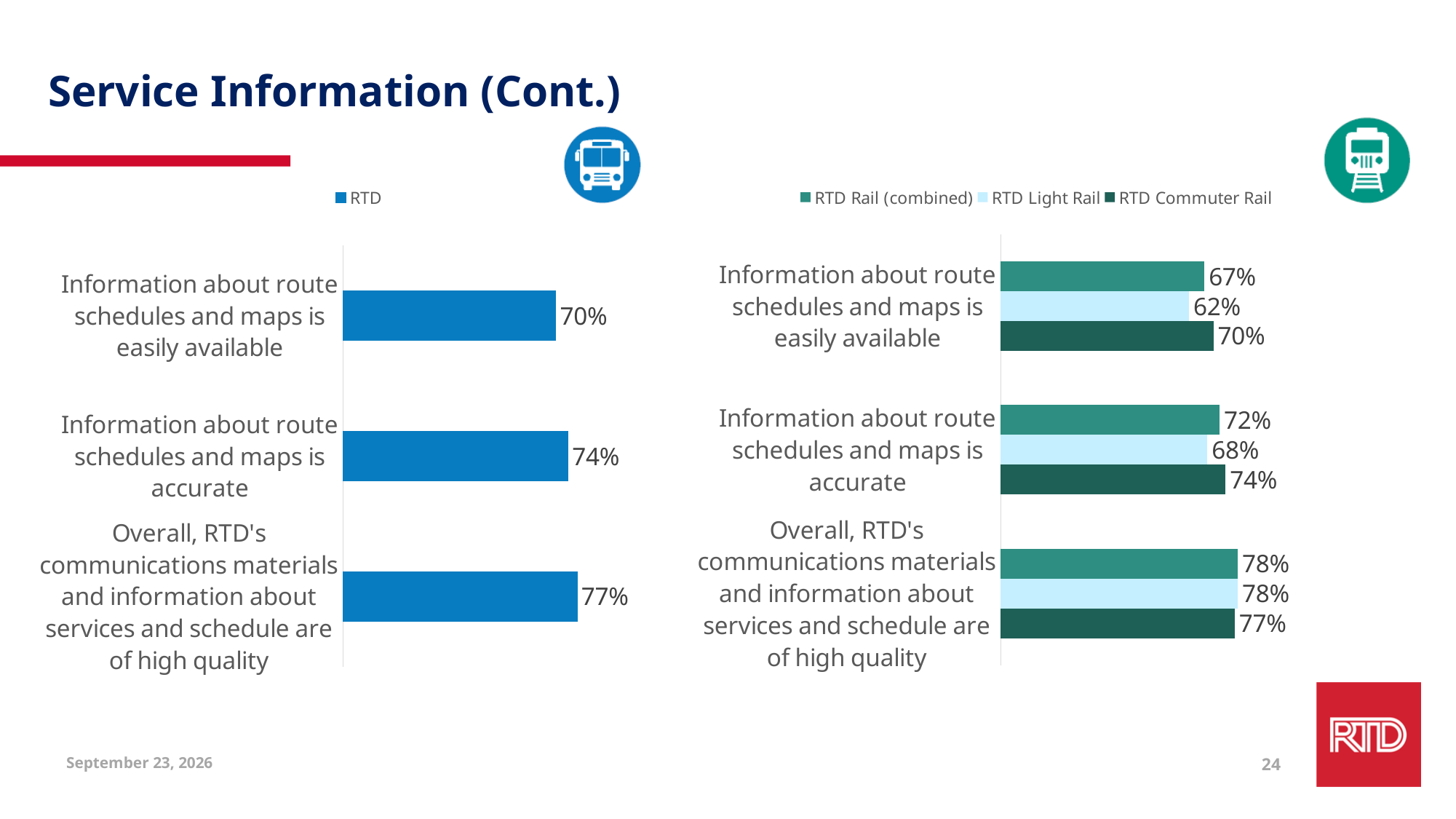
In the left chart (RTD), which category has the lowest value? Information about route schedules and maps is easily available In the right chart (rail), which is larger for "Information about route schedules and maps is accurate": RTD Light Rail or RTD Commuter Rail? RTD Commuter Rail In the left chart (RTD), what is the difference between the value for "Overall, RTD's communications materials and information about services and schedule are of high quality" and the value for "Information about route schedules and maps is easily available"? 7% In the right chart (rail), what is the RTD Commuter Rail value for "Information about route schedules and maps is accurate"? 74% In the right chart (rail), what is the difference between the RTD Commuter Rail and RTD Light Rail values for "Information about route schedules and maps is easily available"? 8% In the right chart (rail), how many series does the legend list? 3 In the left chart (RTD), what is the value for "Information about route schedules and maps is accurate"? 74% How many categories are shown in the left chart (RTD)? 3 What kind of chart is the left chart (RTD)? Bar chart In the right chart (rail), what is the RTD Rail (combined) value for "Overall, RTD's communications materials and information about services and schedule are of high quality"? 78% In the right chart (rail), what is the RTD Light Rail value for "Information about route schedules and maps is easily available"? 62% In the left chart (RTD), which category has the highest value? Overall, RTD's communications materials and information about services and schedule are of high quality